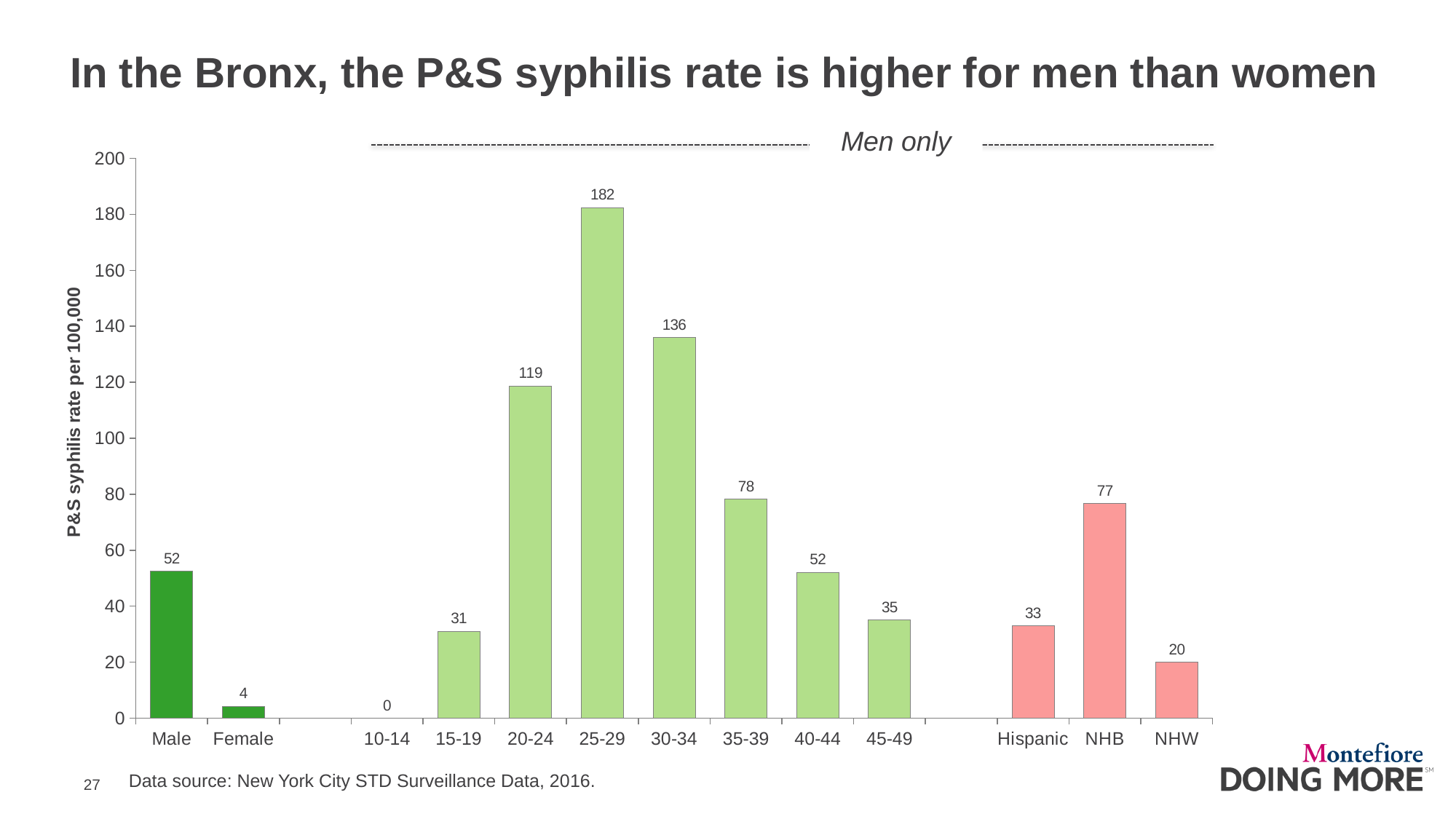
What is the P&S syphilis rate per 100,000 for Male? 52 What kind of chart is shown on the slide? Bar chart What is the label of the vertical axis? P&S syphilis rate per 100,000 How many race/ethnicity categories are shown for men? 3 What is the P&S syphilis rate per 100,000 for men aged 25-29? 182 Which age group has the lowest P&S syphilis rate among men? 10-14 Which has a higher P&S syphilis rate, Hispanic men or NHW men? Hispanic What is the difference between the P&S syphilis rate for men aged 25-29 and men aged 30-34? 46 What is the P&S syphilis rate per 100,000 for NHB men? 77 What is the P&S syphilis rate per 100,000 for Female? 4 Which age group has the highest P&S syphilis rate among men? 25-29 What is the difference between the P&S syphilis rate for Male and Female? 48